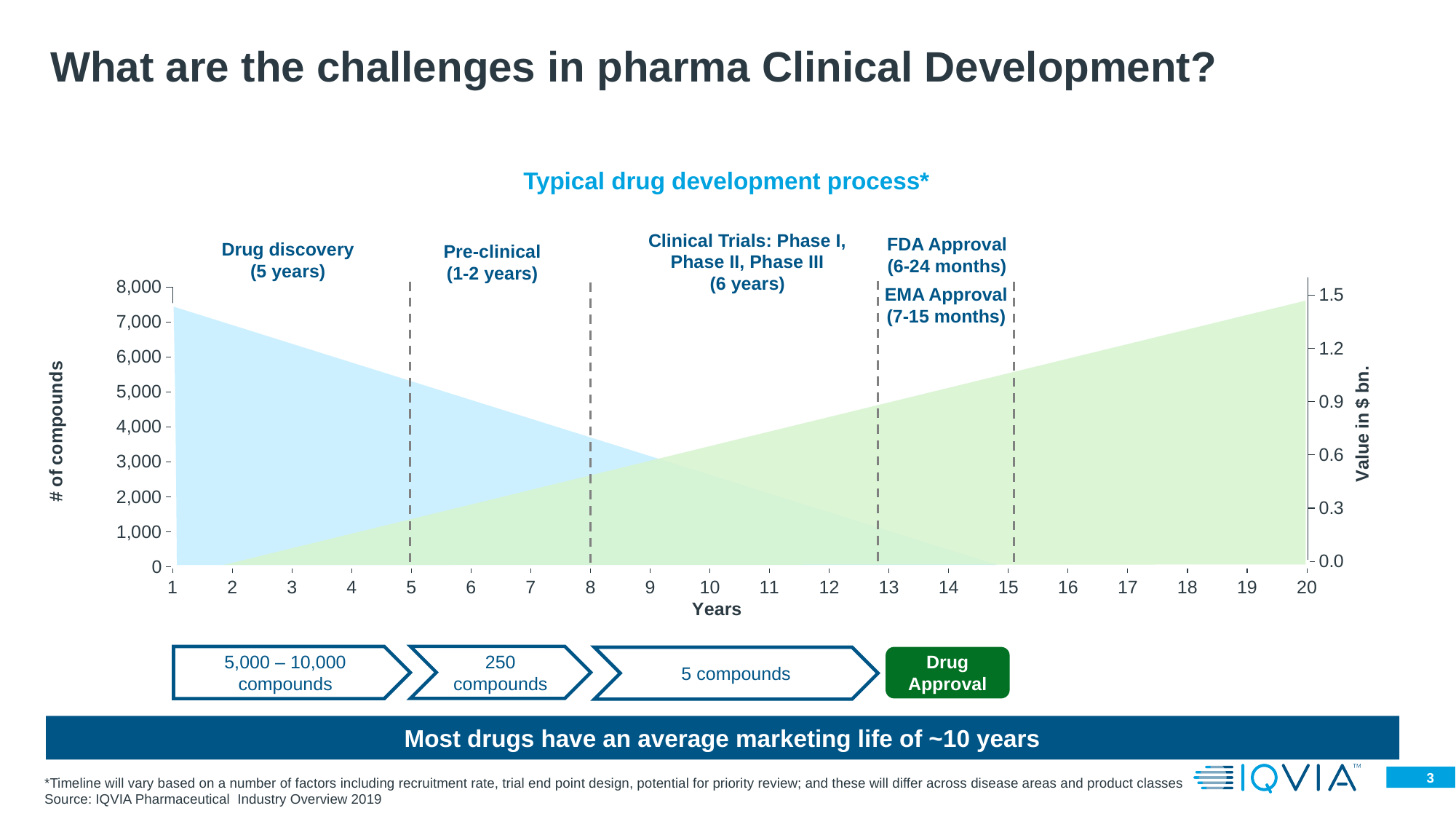
What is the label of the left vertical axis of the chart? # of compounds Does the blue '# of compounds' area rise or fall as the years increase along the x axis? fall Is the number of compounds at year 8 greater or less than 4,000? less Does the green 'Value in $ bn.' area rise or fall as the years increase along the x axis? rise What is the title of the chart? Typical drug development process* Is the value in $ bn. at year 5 greater or less than 0.6? less What kind of chart is shown under the heading 'Typical drug development process*'? area chart Is the number of compounds at year 1 greater or less than 7,000? greater How many year points are shown on the x axis of the chart? 20